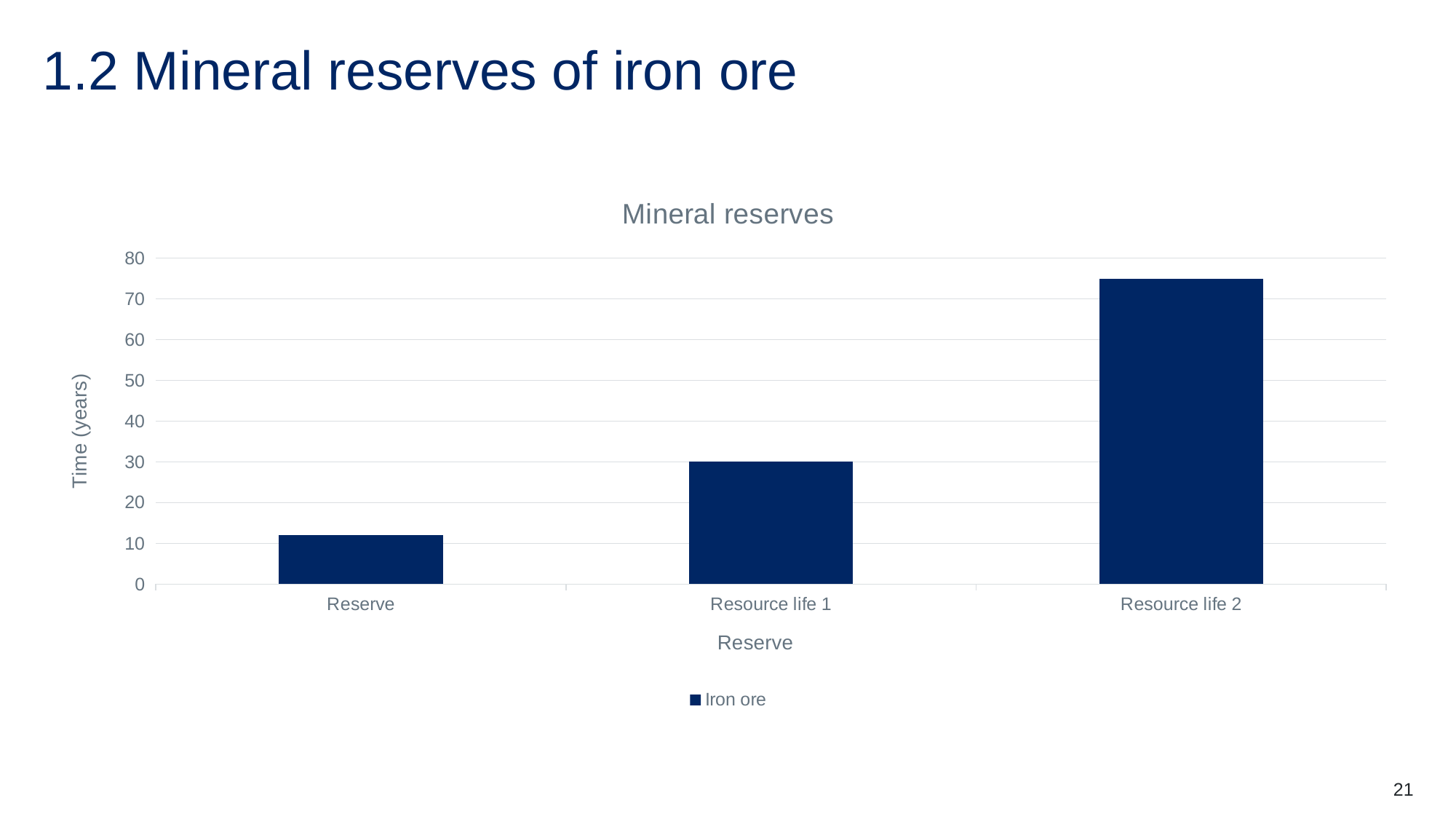
What is the title of the chart? Mineral reserves Which is larger, the value for Reserve or the value for Resource life 1? Resource life 1 Do the values rise or fall from left to right along the x axis? rise What series name is shown in the legend? Iron ore Is the value for Reserve greater or less than 20? less Is the value for Resource life 2 greater or less than 70? greater How many series does the legend list? 1 What is the value for Resource life 1? 30 What kind of chart is shown on the slide? bar chart How many categories are shown on the x axis of the chart? 3 Which category has the lowest value? Reserve Which category has the highest value? Resource life 2